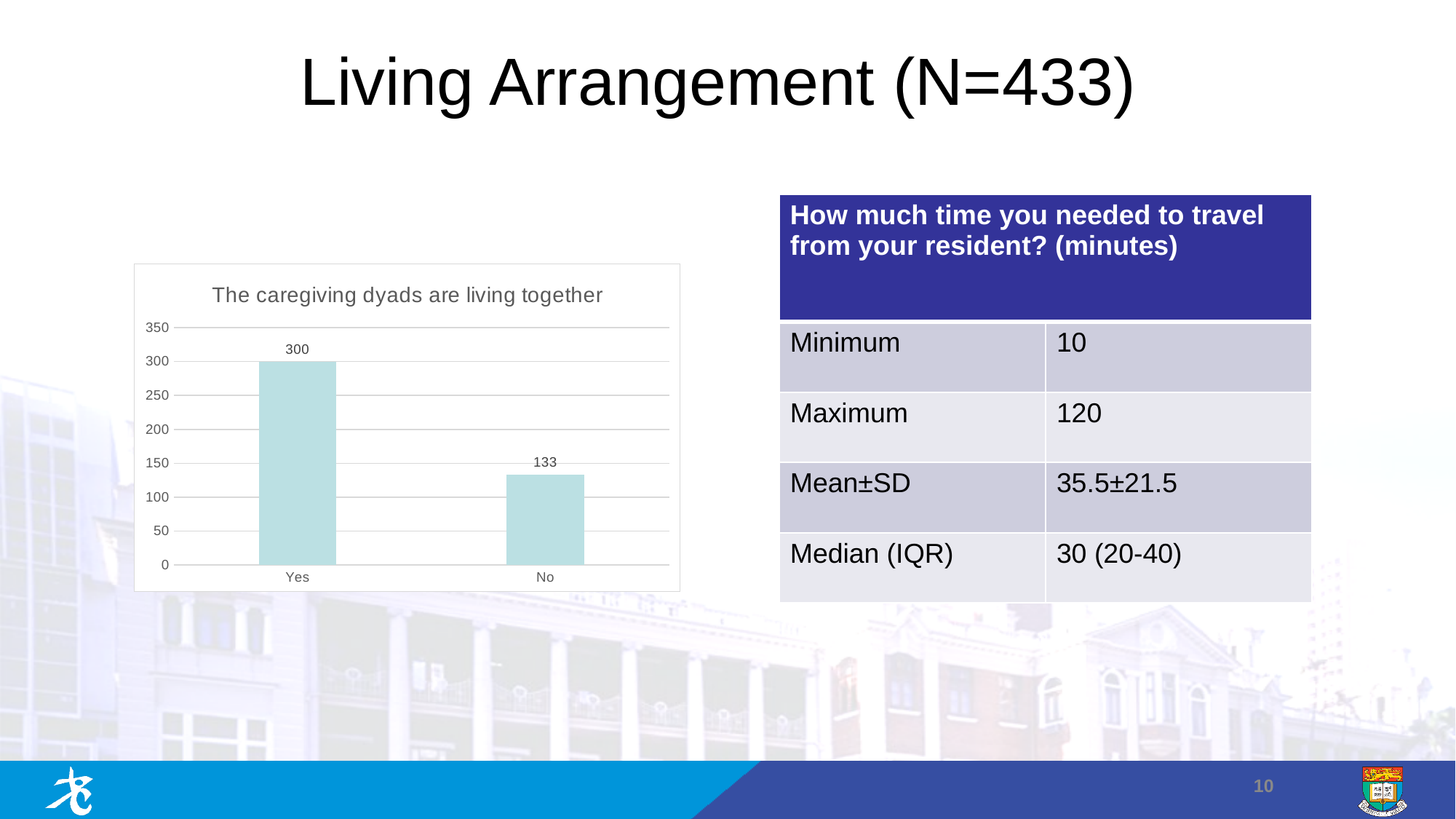
How many categories are shown in the chart? 2 Is the value for No greater or less than 150? less Which category has the lowest value in the chart? No Which category has the highest value in the chart? Yes Is the value for Yes greater or less than 250? greater What kind of chart is shown on the slide? bar chart What is the total of the two bars in the chart? 433 What is the difference between the values for Yes and No? 167 What is the title of the chart? The caregiving dyads are living together What is the value for No in the chart? 133 What is the value for Yes in the chart? 300 Which is larger, the value for Yes or the value for No? Yes